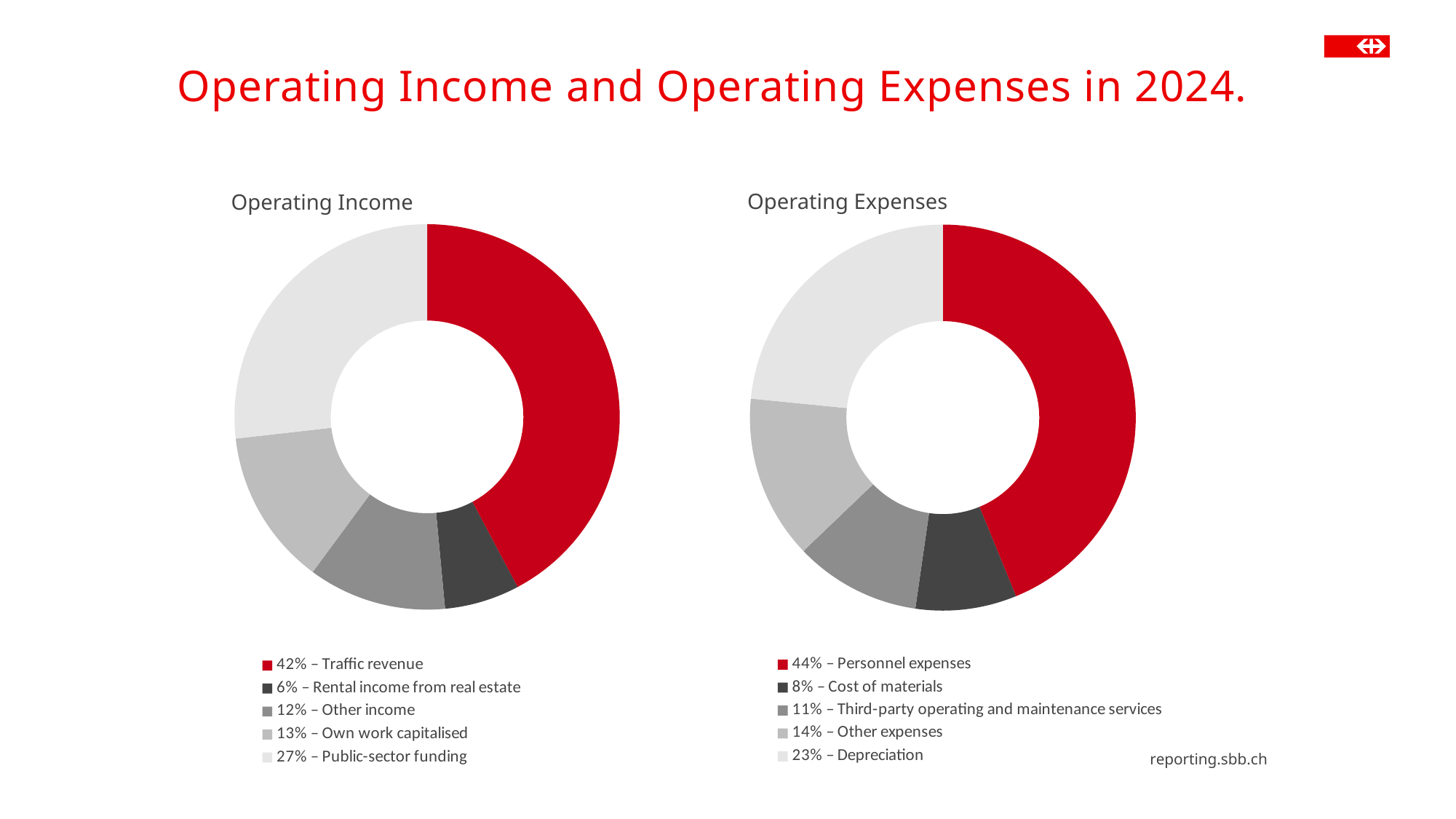
What kind of chart is the Operating Expenses chart? Doughnut chart In the Operating Expenses chart, which category has the smallest share? Cost of materials In the Operating Income chart, what is the difference between Public-sector funding and Own work capitalised? 14% In the Operating Expenses chart, what share is Depreciation? 23% In the Operating Expenses chart, which category has the largest share? Personnel expenses In the Operating Expenses chart, which is larger: Other expenses or Third-party operating and maintenance services? Other expenses In the Operating Expenses chart, what is the difference between Personnel expenses and Depreciation? 21% In the Operating Income chart, what colour is the Traffic revenue slice? Red How many categories does the Operating Income chart show? 5 In the Operating Income chart, which category has the largest share? Traffic revenue In the Operating Income chart, what share is Traffic revenue? 42% In the Operating Income chart, which category has the smallest share? Rental income from real estate